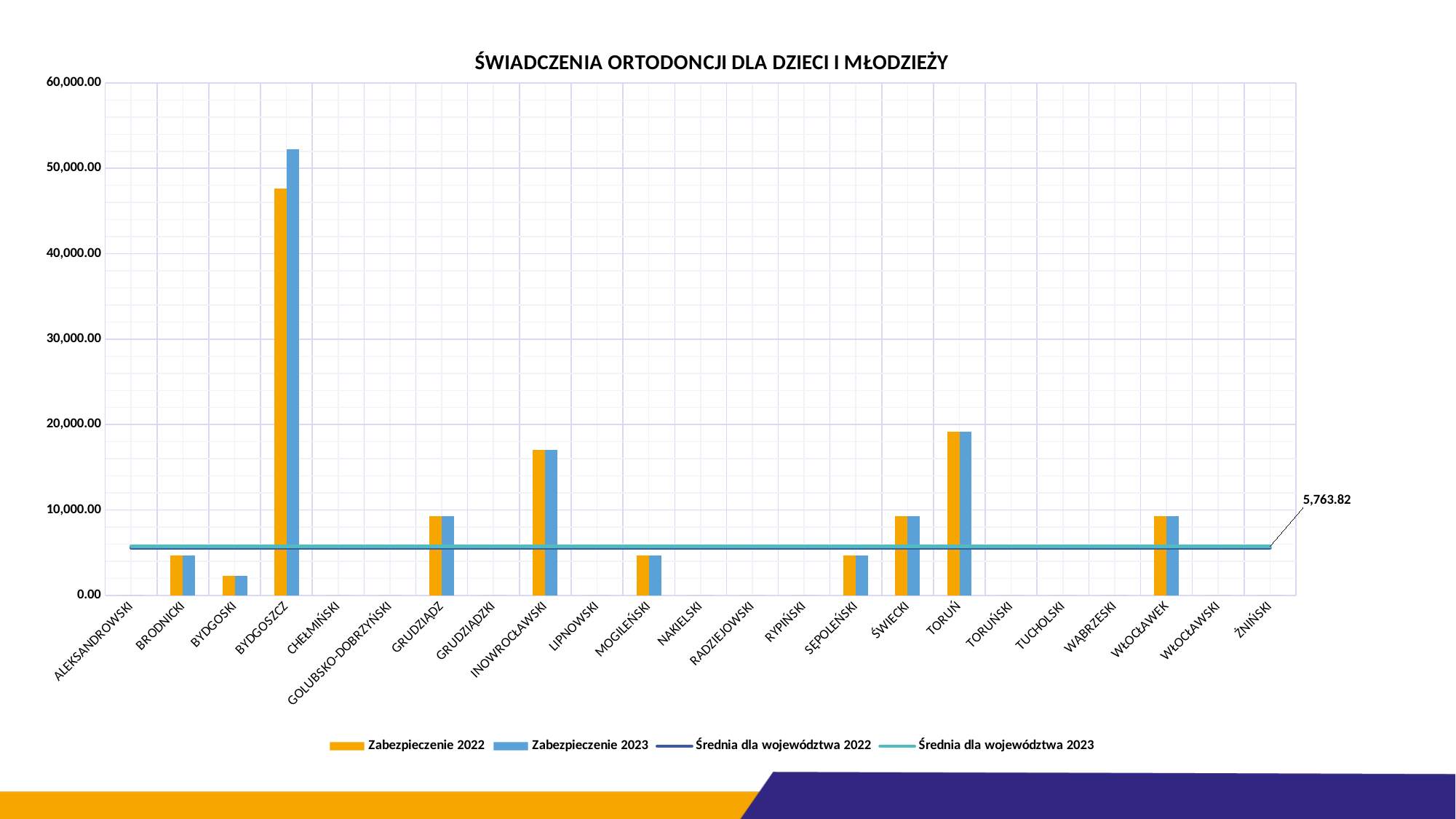
What is the title of the chart? ŚWIADCZENIA ORTODONCJI DLA DZIECI I MŁODZIEŻY Which category has the highest value for Zabezpieczenie 2022? BYDGOSZCZ What value is printed as a data label at the right end of the average line? 5,763.82 How many categories are shown on the x axis? 23 How many series does the legend list? 4 Is the Zabezpieczenie 2023 value for TORUŃ greater or less than 20,000.00? less Is the Zabezpieczenie 2022 value for BYDGOSZCZ greater or less than 50,000.00? less For BYDGOSZCZ, which is larger: Zabezpieczenie 2022 or Zabezpieczenie 2023? Zabezpieczenie 2023 Is the Zabezpieczenie 2023 value for BYDGOSZCZ greater or less than 50,000.00? greater What kind of chart is shown on the slide? combination bar and line chart Which category has the highest value for Zabezpieczenie 2023? BYDGOSZCZ Which has the larger Zabezpieczenie 2022 value: TORUŃ or INOWROCŁAWSKI? TORUŃ